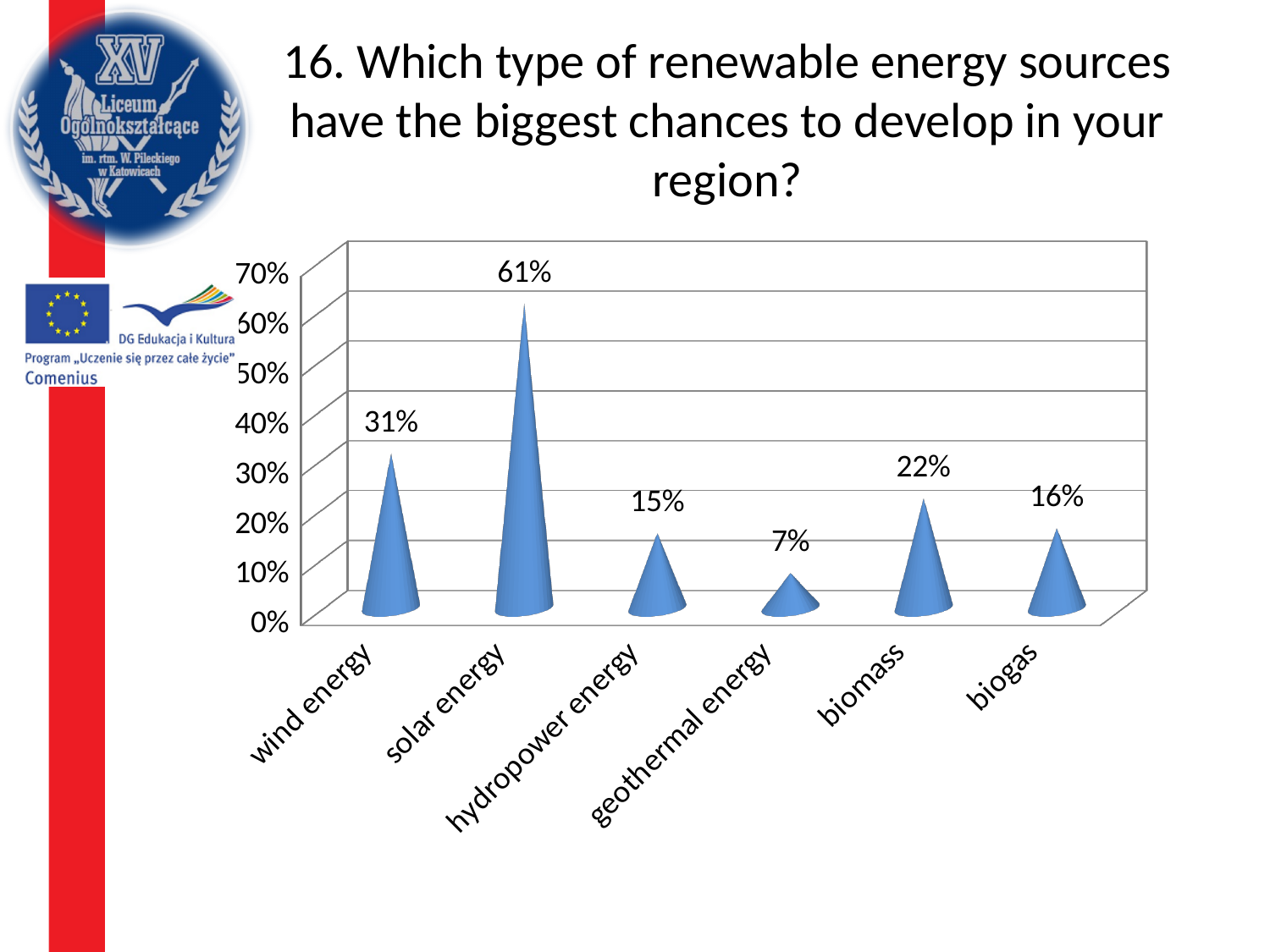
What is the value for biomass? 22% Which category has the highest value? solar energy What kind of chart is shown on the slide? bar chart What is the value for geothermal energy? 7% How many categories are shown on the x axis? 6 Which category has the lowest value? geothermal energy What is the value for solar energy? 61% What is the difference between the values for biomass and biogas? 6% What is the title of the slide above the chart? 16. Which type of renewable energy sources have the biggest chances to develop in your region? What is the value for wind energy? 31% Which is larger, the value for hydropower energy or the value for biogas? biogas What is the difference between the values for solar energy and wind energy? 30%